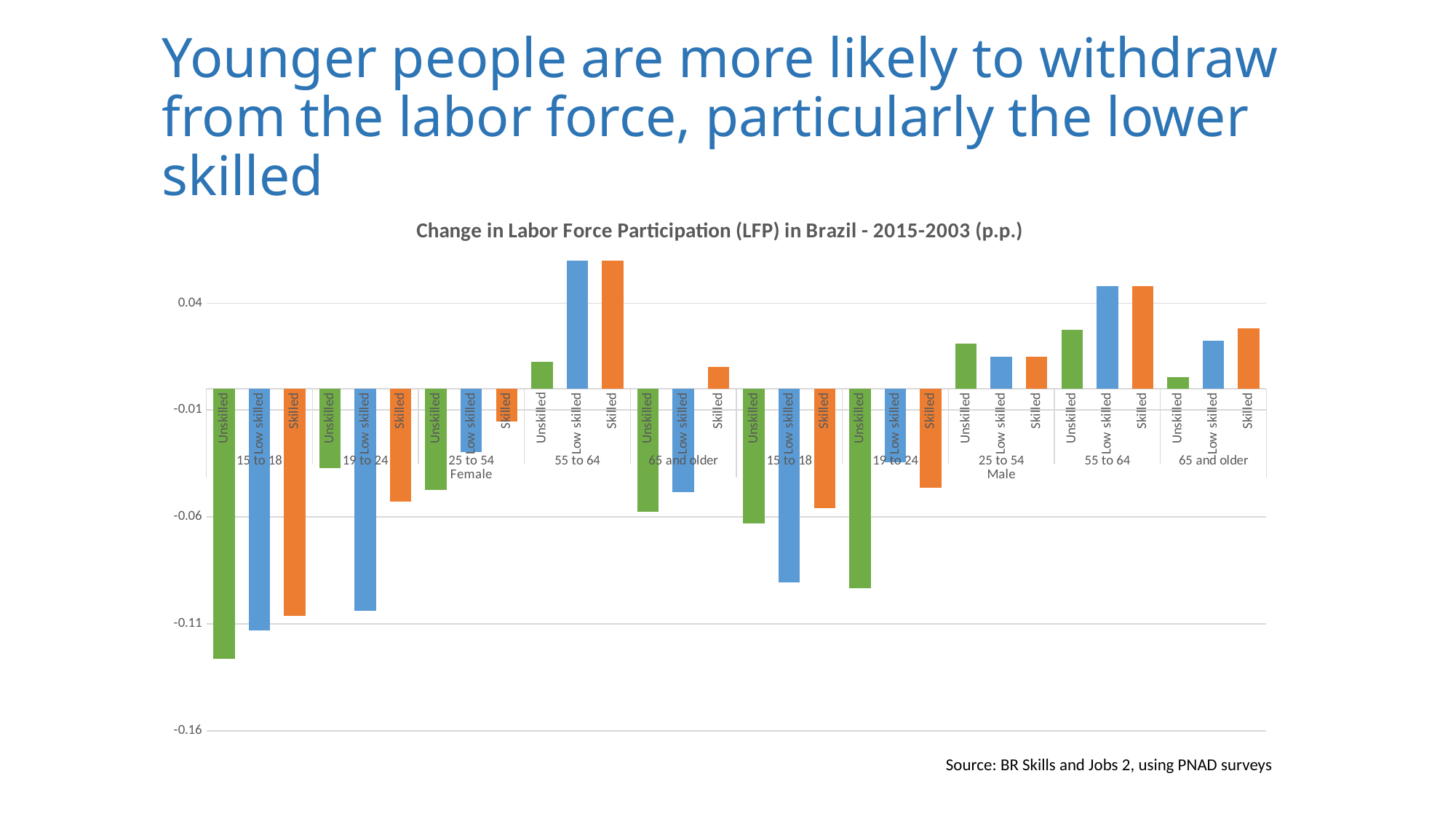
Which is larger: the Low skilled value for Female 55 to 64 or the Low skilled value for Male 55 to 64? Female 55 to 64 What is the title of the chart? Change in Labor Force Participation (LFP) in Brazil - 2015-2003 (p.p.) What kind of chart is shown on the slide? Bar chart How many age groups are shown for the Female group? 5 Is the value for Unskilled in the Female 15 to 18 group greater or less than -0.11? less What colour are the Skilled bars on the chart? Orange Is the value for Low skilled in the Male 55 to 64 group greater or less than 0.04? greater How many bars are plotted in total on the chart? 30 Which is larger: the Unskilled value for Female 15 to 18 or the Unskilled value for Male 15 to 18? Male 15 to 18 Which bar has the lowest value on the chart? Unskilled, Female 15 to 18 Is the value for Low skilled in the Male 15 to 18 group greater or less than -0.06? less